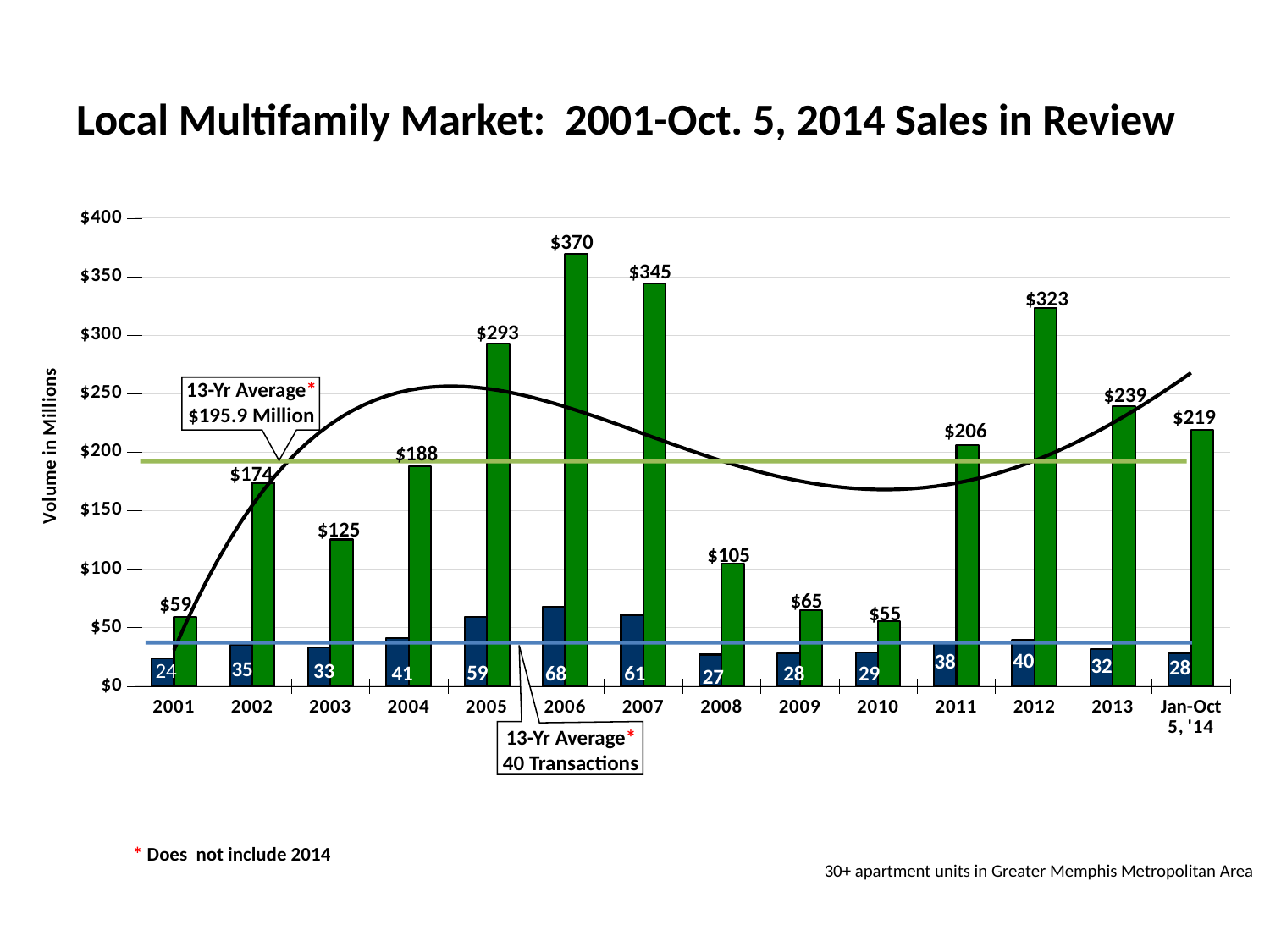
What is the title of the chart? Local Multifamily Market: 2001-Oct. 5, 2014 Sales in Review What is the sales volume shown for 2006? $370 What is the difference in sales volume between 2012 and 2013? $84 Which year has the highest sales volume? 2006 Which has the larger sales volume, 2007 or 2011? 2007 Does the sales volume rise or fall from 2008 to 2010? Fall How many transactions are shown for 2005? 59 What kind of chart is this? Bar chart Which year has the lowest number of transactions? 2001 Which year has the lowest sales volume? 2010 What is the 13-year average sales volume shown in the callout? $195.9 Million How many time periods are shown on the x axis? 14